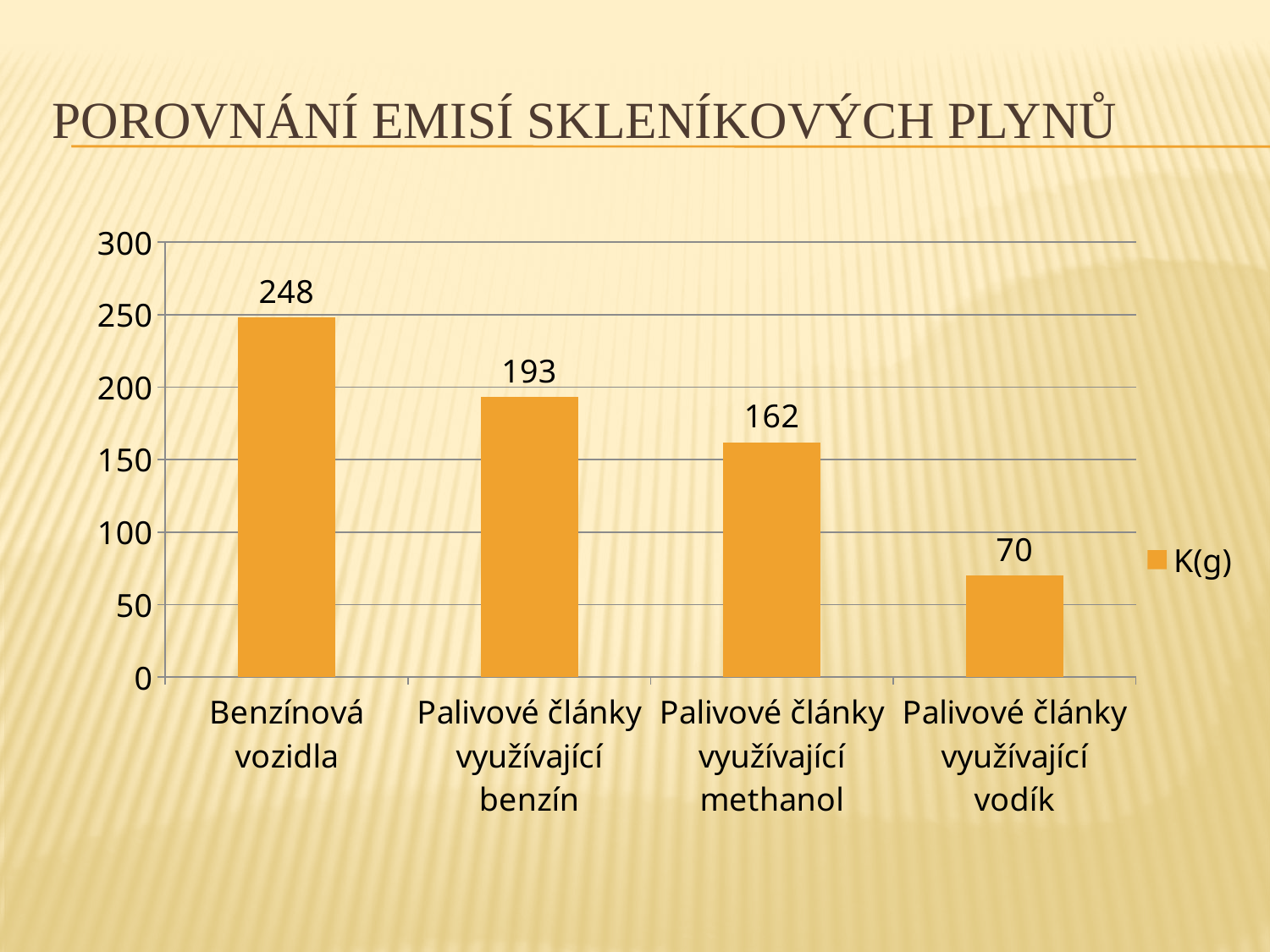
Which category has the lowest value? Palivové články využívající vodík What is the value for Palivové články využívající vodík? 70 What is the difference between the values for Benzínová vozidla and Palivové články využívající benzín? 55 How many series does the legend list? 1 Which is larger: the value for Palivové články využívající benzín or Palivové články využívající methanol? Palivové články využívající benzín What is the value for Palivové články využívající methanol? 162 How many categories are shown in the chart? 4 What is the value for Benzínová vozidla? 248 Do the values rise or fall from left to right along the x axis? Fall What kind of chart is shown on the slide? Bar chart What is the difference between the values for Palivové články využívající methanol and Palivové články využívající vodík? 92 Which category has the highest value? Benzínová vozidla